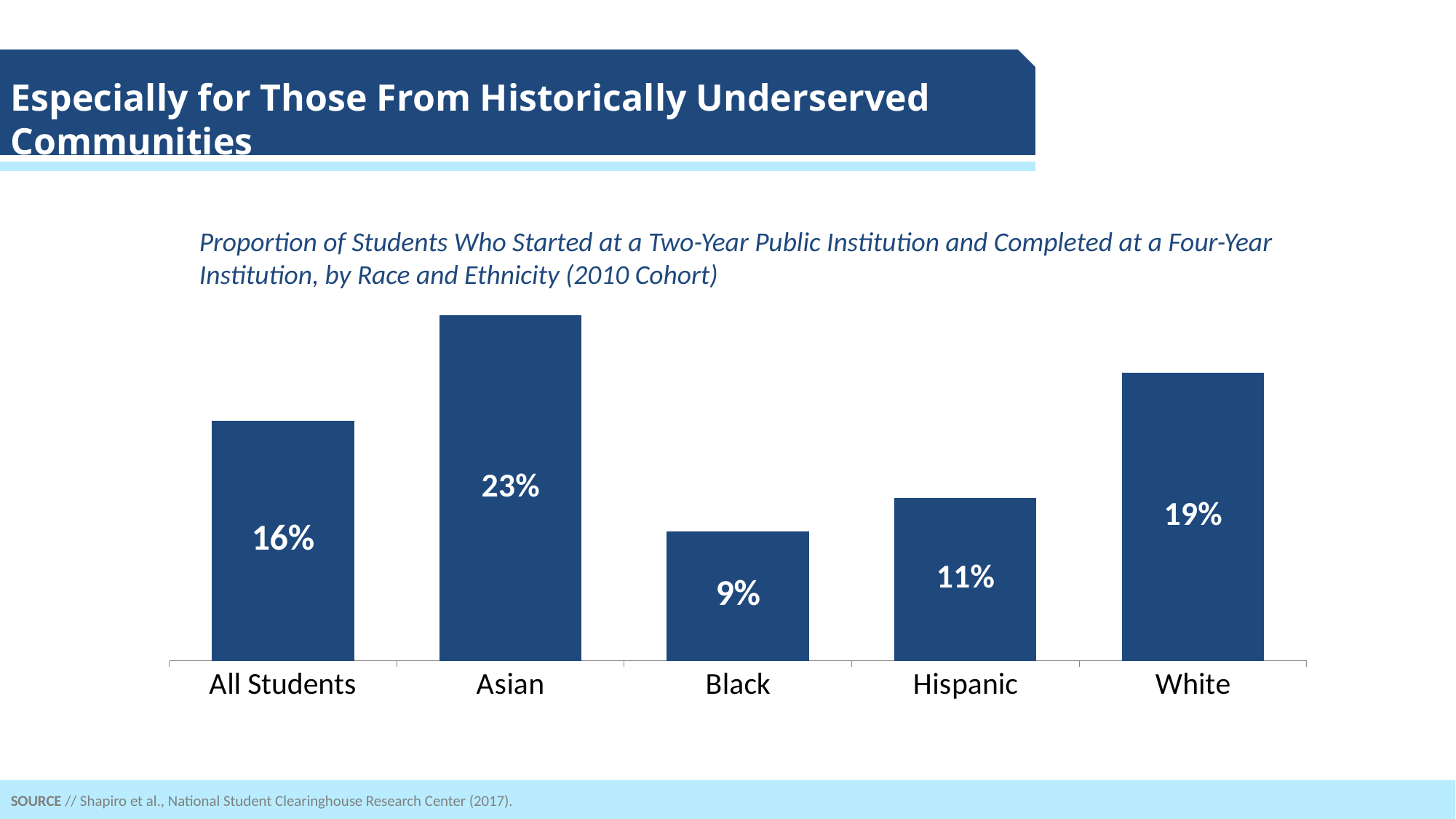
What is the value for Hispanic? 11% Which category has the lowest value? Black What is the value for Black? 9% What kind of chart is this? Bar chart What cohort year is named in the chart title? 2010 Which is larger, the value for White or the value for All Students? White What is the difference between the values for White and Hispanic? 8% How many categories are shown on the x axis? 5 What is the difference between the values for Asian and Black? 14% What is the value for All Students? 16% Which category has the highest value? Asian What is the value for Asian? 23%